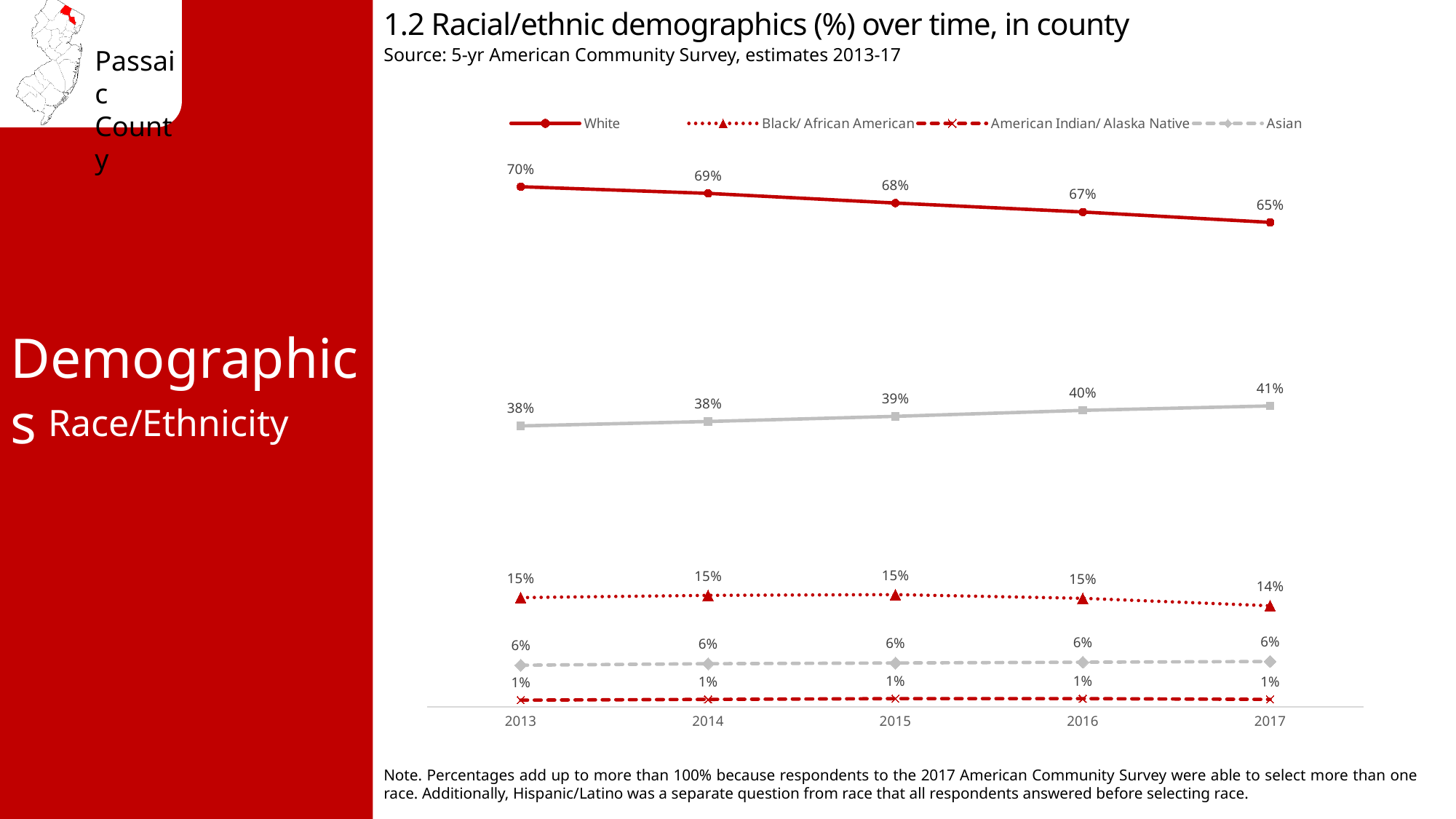
What kind of chart is shown on the slide? Line chart Does the White series rise or fall from 2013 to 2017? Fall What is the value for American Indian/ Alaska Native in 2016? 1% What is the value for Asian in 2015? 6% By how many percentage points did the White value change from 2013 to 2017? 5 percentage points What is the value for White in 2013? 70% How many series does the legend list? 4 Which legend series has the lowest value in 2013? American Indian/ Alaska Native What is the value for Black/ African American in 2017? 14% How many years are shown on the x axis? 5 Which legend series has the highest value in 2017? White What is the value for White in 2017? 65%